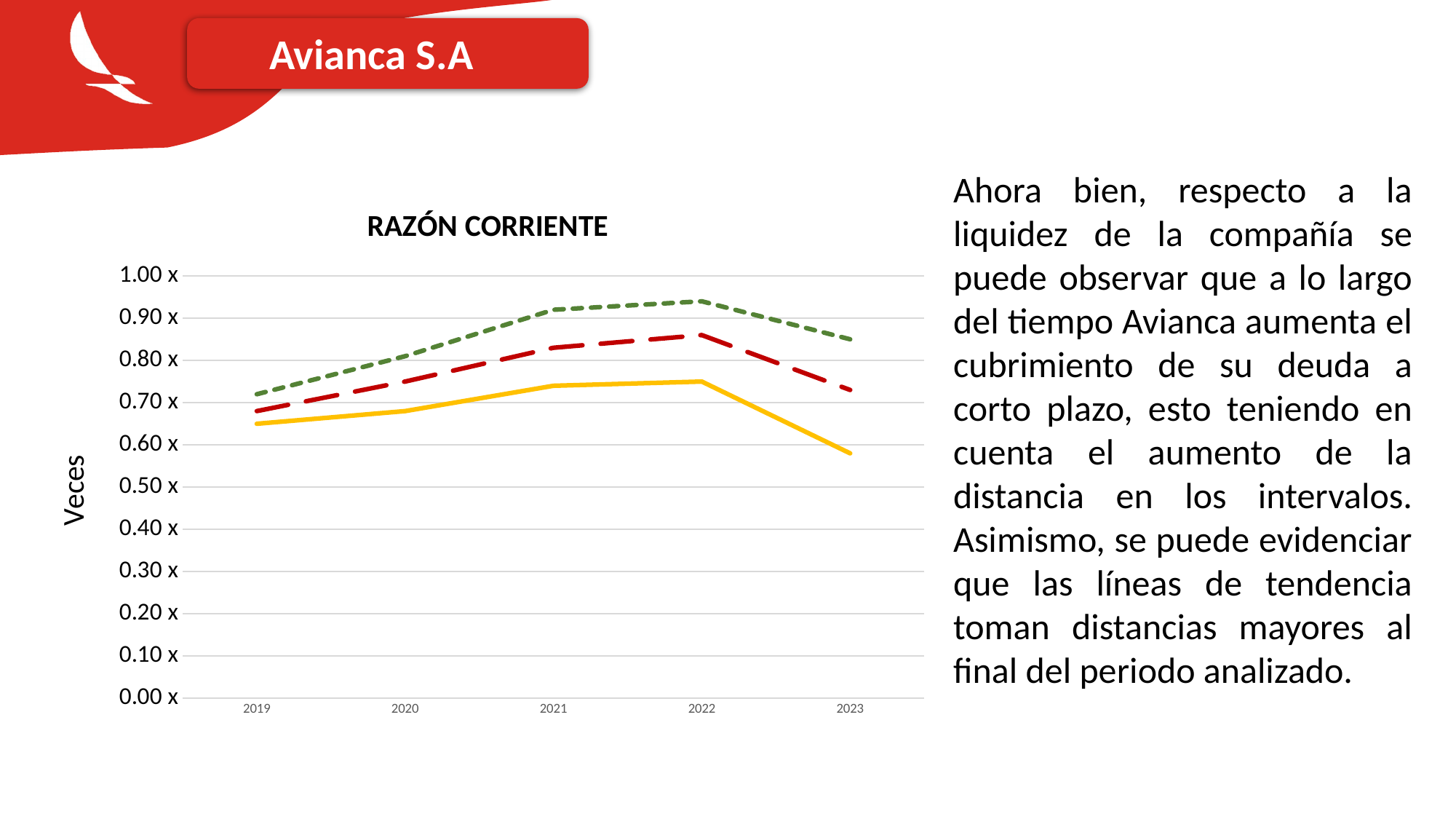
Is the value of the green dotted line in 2022 greater or less than 0.90 x? greater In which year does the red dashed line reach its highest value? 2022 What is the label on the vertical axis of the chart? Veces Is the value of the red dashed line in 2022 greater or less than 0.80 x? greater Is the value of the yellow solid line in 2023 greater or less than 0.60 x? less What type of chart is shown on the slide? line chart What is the title of the chart? RAZÓN CORRIENTE Do the lines rise or fall between 2022 and 2023? fall How many lines are plotted on the chart? 3 How many years are shown on the x axis of the chart? 5 In which year does the yellow solid line reach its lowest value? 2023